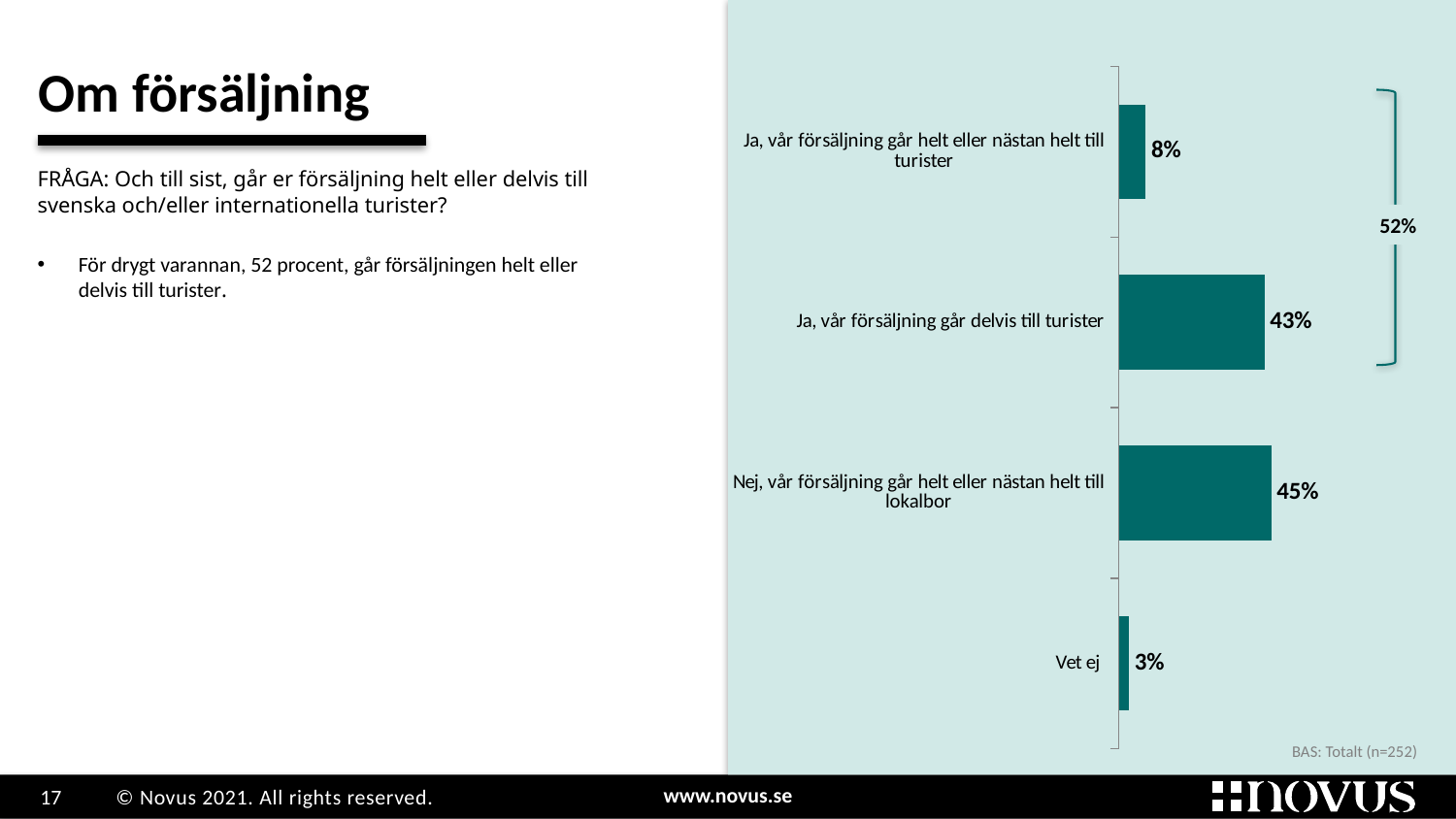
What is the difference between the values for "Nej, vår försäljning går helt eller nästan helt till lokalbor" and "Ja, vår försäljning går delvis till turister"? 2% What kind of chart is shown on the slide? Bar chart What is the value for "Ja, vår försäljning går helt eller nästan helt till turister"? 8% What is the value for "Nej, vår försäljning går helt eller nästan helt till lokalbor"? 45% What is the base (n) stated at the bottom of the chart? Totalt (n=252) Which category has the lowest value? Vet ej What combined percentage is shown by the bracket grouping the two "Ja" categories? 52% How many categories are shown in the chart? 4 Which category has the highest value? Nej, vår försäljning går helt eller nästan helt till lokalbor Which is larger: the value for "Ja, vår försäljning går helt eller nästan helt till turister" or the value for "Vet ej"? Ja, vår försäljning går helt eller nästan helt till turister What is the value for "Ja, vår försäljning går delvis till turister"? 43% What is the value for "Vet ej"? 3%